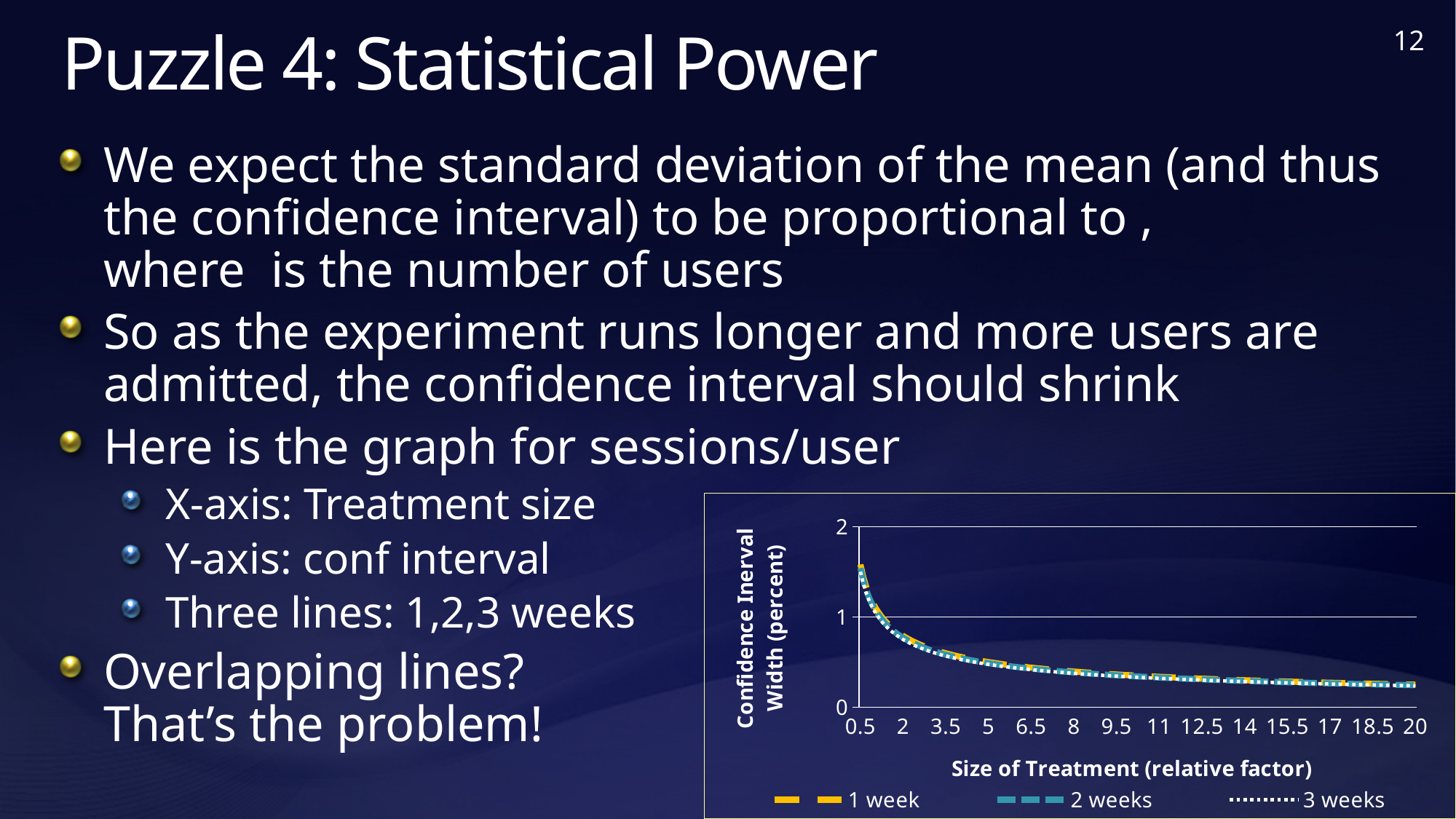
How many tick labels are shown on the chart's x-axis? 14 Is the confidence interval width at a treatment size of 0.5 greater or less than 1? greater Which has a larger confidence interval width: a treatment size of 2 or a treatment size of 20? 2 At which size of treatment is the confidence interval width highest? 0.5 What kind of chart is shown on the slide? line chart At which size of treatment is the confidence interval width lowest? 20 What are the three series named in the chart's legend? 1 week, 2 weeks, 3 weeks Is the confidence interval width at a treatment size of 5 greater or less than 1? less Is the confidence interval width at a treatment size of 20 greater or less than 1? less What is the title of the chart's x-axis? Size of Treatment (relative factor) How many series does the chart's legend list? 3 Do the confidence interval width values rise or fall as the size of treatment increases along the x-axis? fall